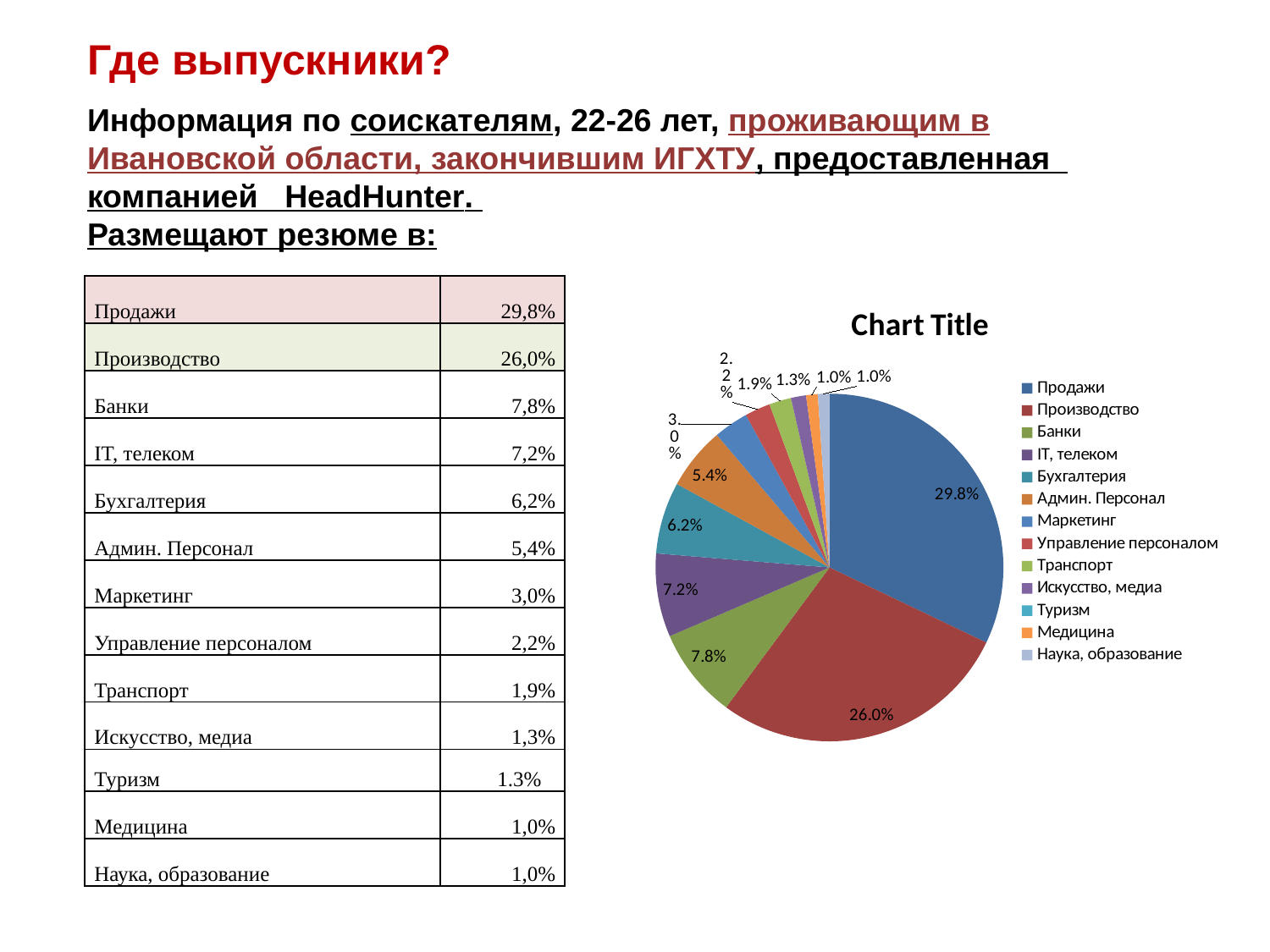
What is the value shown for Бухгалтерия on the pie chart? 6.2% What share of the pie does Продажи have? 29.8% What is the value shown for Банки on the pie chart? 7.8% How many categories does the legend of the pie chart list? 13 What is the value shown for IT, телеком on the pie chart? 7.2% What is the difference between the shares of Продажи and Производство? 3.8% What kind of chart is shown on the slide? pie chart What share of the pie does Производство have? 26.0% What is the chart's title? Chart Title Which is larger, the slice for Банки or the slice for Админ. Персонал? Банки Which legend entry is listed first in the pie chart's legend? Продажи Which category has the largest slice of the pie? Продажи